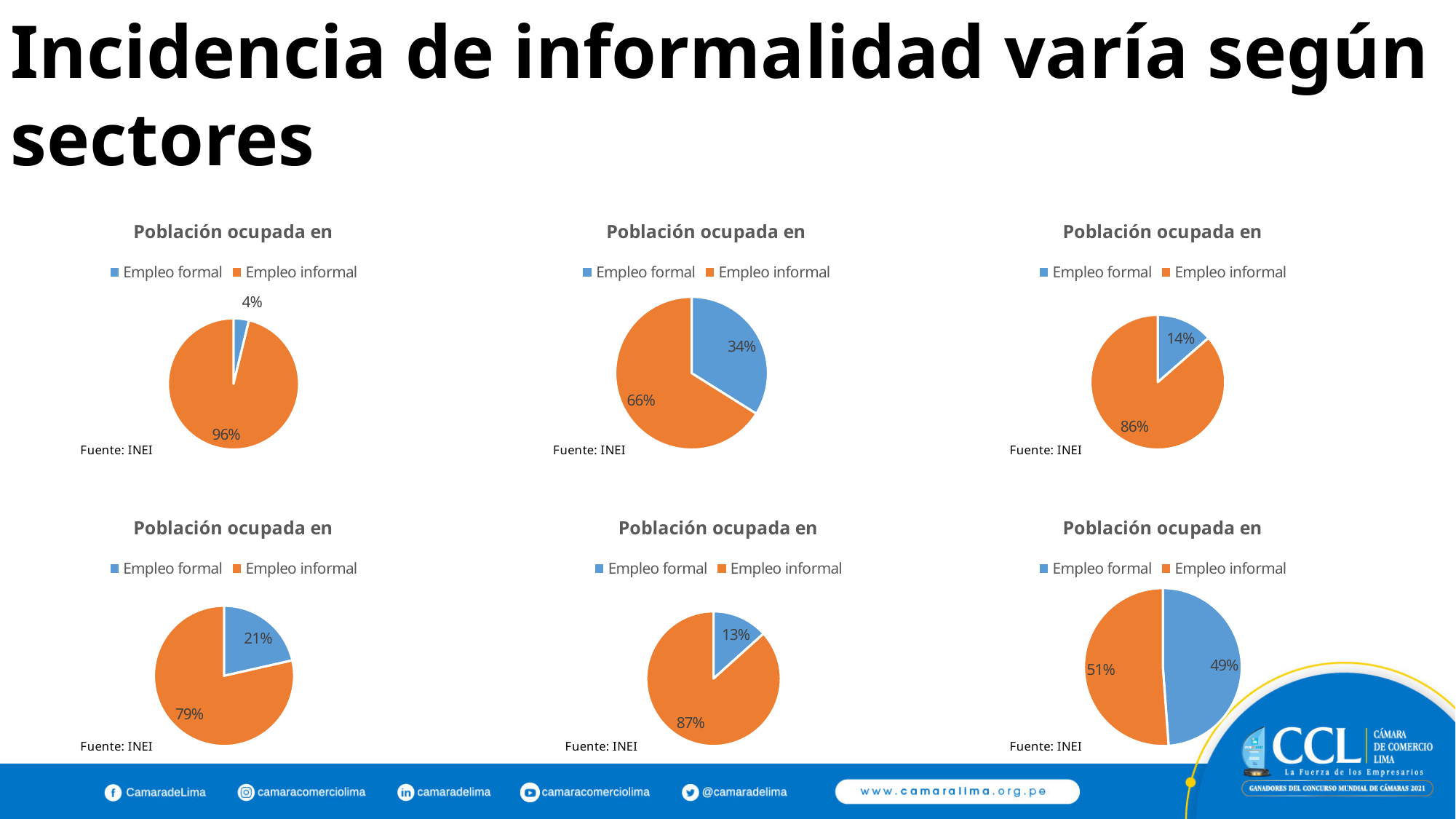
In the top-middle pie chart, what share is Empleo formal? 34% In the bottom-right pie chart, which slice is larger, Empleo formal or Empleo informal? Empleo informal In the top-right pie chart, what share is Empleo informal? 86% In the top-right pie chart, what colour is the Empleo informal slice? Orange What kind of chart is the bottom-left chart? Pie chart In the bottom-left pie chart, what share is Empleo formal? 21% In the top-middle pie chart, what is the difference in percentage points between Empleo informal and Empleo formal? 32 In the bottom-right pie chart, what share is Empleo formal? 49% In the top-left pie chart, what share is Empleo formal? 4% In the top-left pie chart, what share is Empleo informal? 96% In the bottom-middle pie chart, what share is Empleo informal? 87% How many series does the legend of the top-left chart list? 2